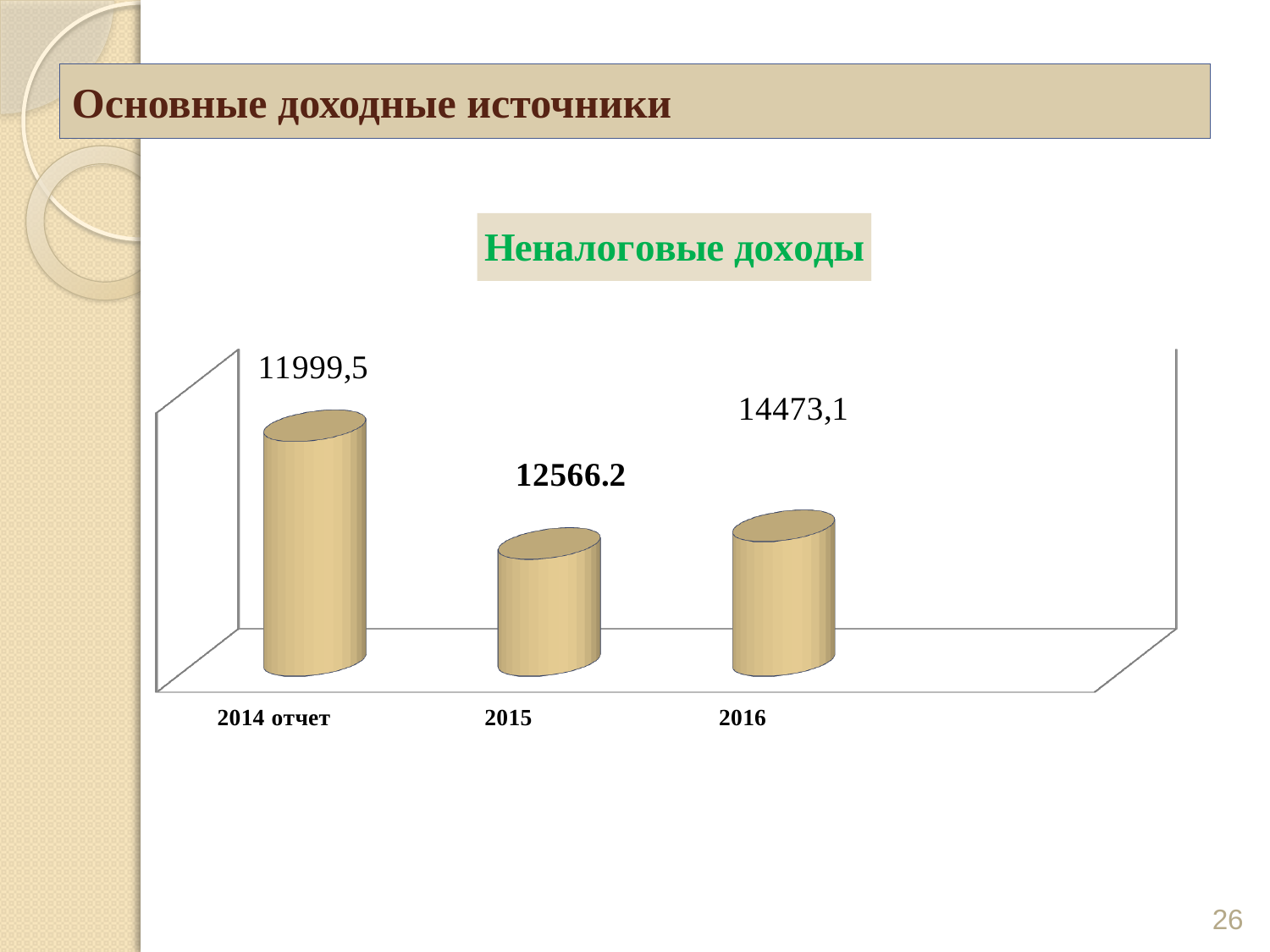
What is the difference between the labelled values for 2016 and 2015? 1906,9 What is the label of the first category on the x axis of the chart? 2014 отчет What is the value shown for 2016 in the Неналоговые доходы chart? 14473,1 What is the value shown for 2015 in the Неналоговые доходы chart? 12566.2 What is the title of the chart on the slide? Неналоговые доходы What is the value shown for 2014 отчет in the Неналоговые доходы chart? 11999,5 By how much does the labelled value for 2016 exceed the labelled value for 2014 отчет? 2473,6 How many categories are plotted in the Неналоговые доходы chart? 3 What kind of chart is used to show Неналоговые доходы? Bar chart